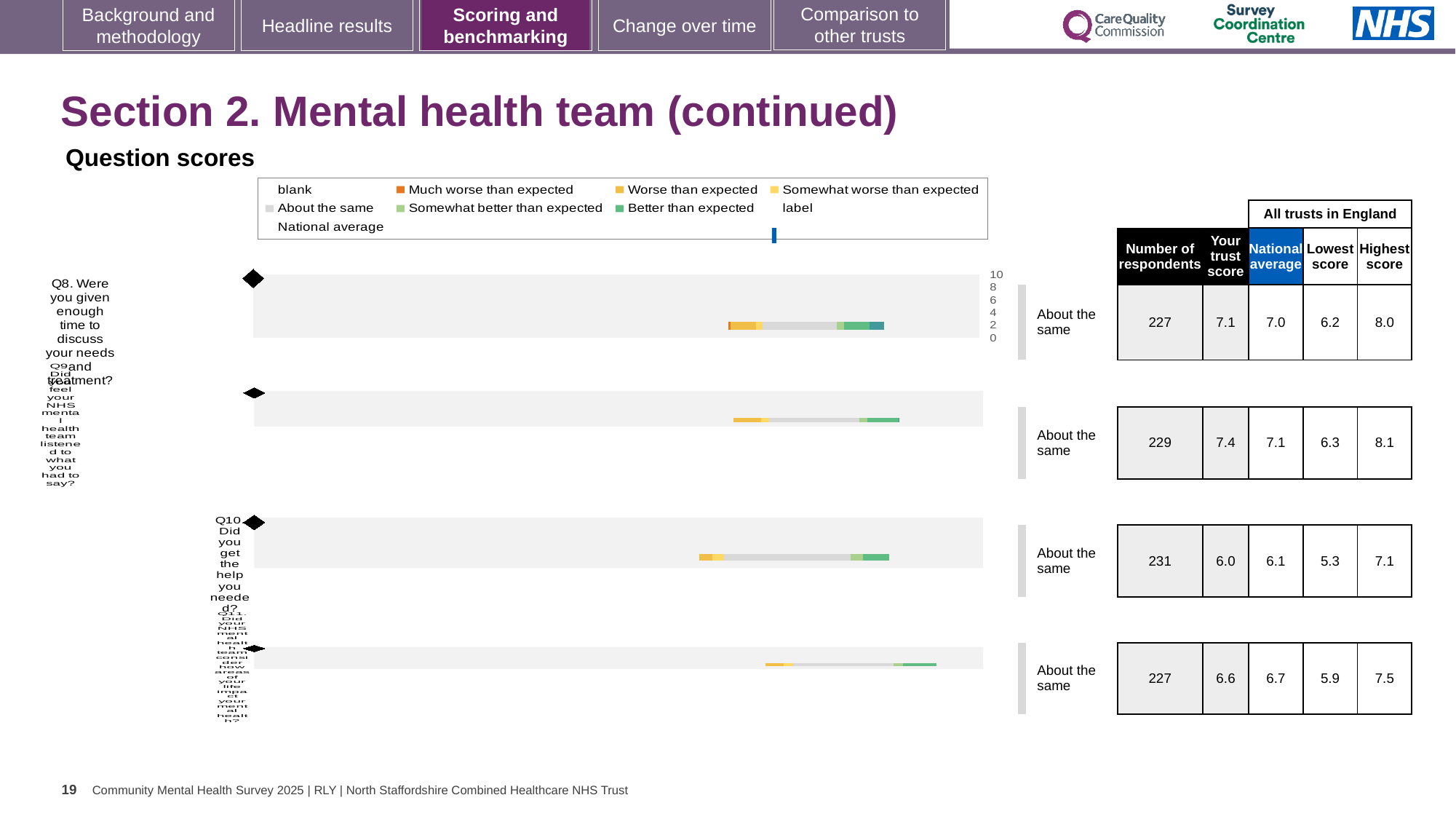
In the table beside the Q10 chart ('Did you get the help you needed?'), what is 'Your trust score'? 6.0 In the chart legend, what colour represents 'Much worse than expected'? orange What benchmark category is shown next to the Q8 chart? About the same In the table beside the Q8 chart, which is larger: 'Your trust score' or the national average? Your trust score In the table beside the Q8 chart, what is the national average? 7.0 In the table beside the Q10 chart, what is the highest score across all trusts in England? 7.1 What kind of chart is used for the Q8 question score? bar chart In the chart legend, what colour represents 'About the same'? grey In the table beside the Q8 chart, what is the number of respondents? 227 In the table beside the Q8 chart, what is the difference between the highest score and the lowest score? 1.8 In the table beside the Q8 chart, what is 'Your trust score'? 7.1 How many question-score charts are shown on the slide? 4